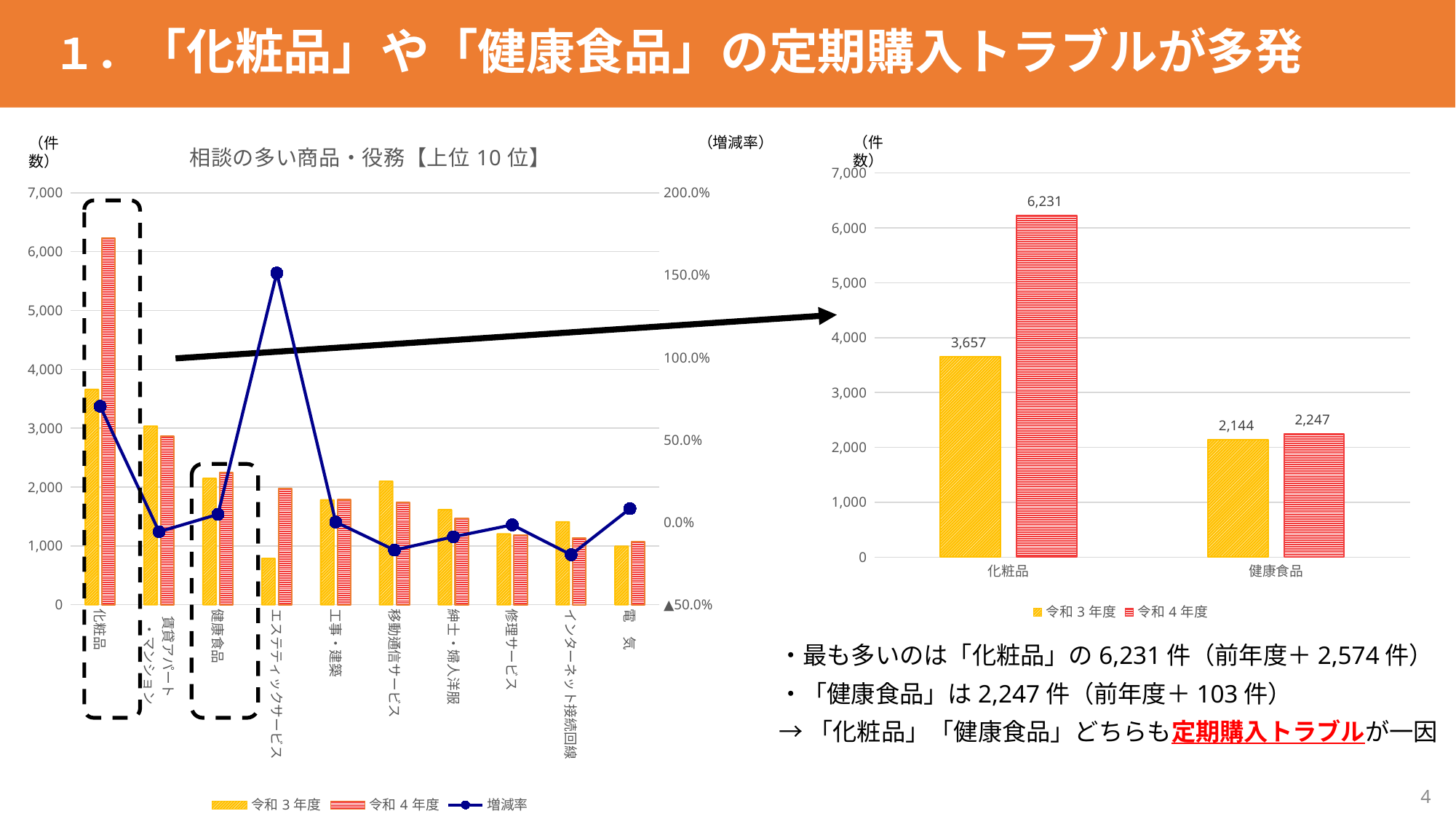
On the right chart, which is larger: 健康食品 in 令和3年度 or 健康食品 in 令和4年度? 健康食品 in 令和4年度 On the right chart, how many series does the legend list? 2 On the chart titled 相談の多い商品・役務【上位10位】, how many categories are shown on the x axis? 10 On the right chart, what is the value for 健康食品 in 令和4年度? 2,247 On the right chart, what is the difference between the 令和4年度 and 令和3年度 values for 化粧品? 2,574 On the right chart, what is the value for 健康食品 in 令和3年度? 2,144 On the right chart, what is the value for 化粧品 in 令和3年度? 3,657 On the right chart, what is the difference between the 令和4年度 and 令和3年度 values for 健康食品? 103 On the chart titled 相談の多い商品・役務【上位10位】, which category has the highest 令和4年度 bar? 化粧品 On the chart titled 相談の多い商品・役務【上位10位】, how many series does the legend list? 3 On the right chart, what is the value for 化粧品 in 令和4年度? 6,231 On the chart titled 相談の多い商品・役務【上位10位】, is the 増減率 value for エステティックサービス greater or less than 100.0%? greater